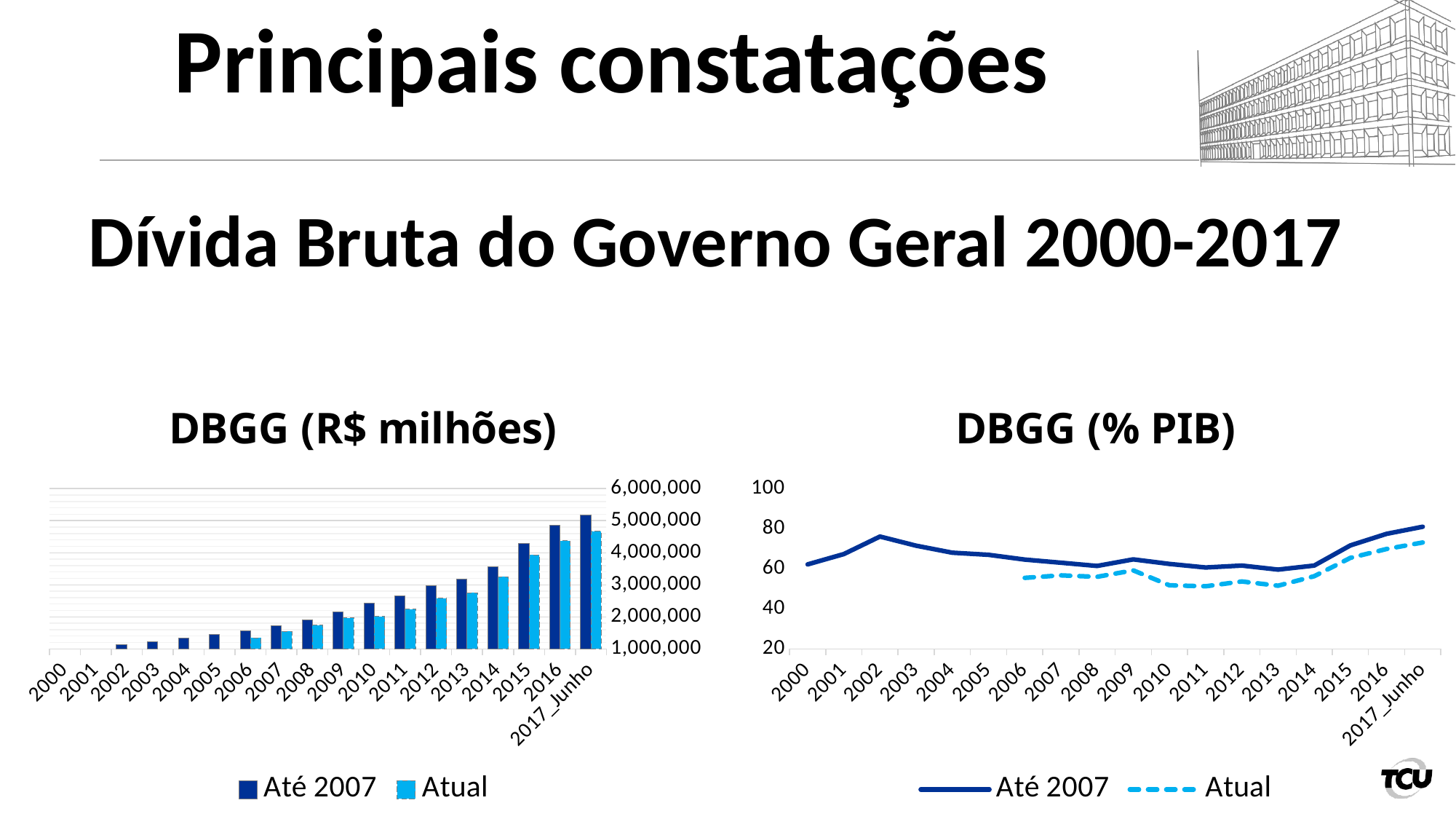
In the 'DBGG (% PIB)' chart, is the 'Atual' value for 2010 greater or less than 60? less In the 'DBGG (R$ milhões)' chart, is the 'Atual' value for 2017_Junho greater or less than 4,000,000? greater How many categories are shown on the x axis of the 'DBGG (R$ milhões)' chart? 18 What kind of chart is the 'DBGG (% PIB)' chart on the right? line chart What kind of chart is the 'DBGG (R$ milhões)' chart on the left? bar chart In the 'DBGG (R$ milhões)' chart, do the 'Até 2007' values generally rise or fall from 2002 to 2017_Junho? rise How many series does the legend of the 'DBGG (R$ milhões)' chart list? 2 In the 'DBGG (R$ milhões)' chart, which is larger for 2017_Junho: 'Até 2007' or 'Atual'? Até 2007 In the 'DBGG (R$ milhões)' chart, which category has the highest 'Até 2007' bar? 2017_Junho In the 'DBGG (% PIB)' chart, is the 'Até 2007' value for 2002 greater or less than 70? greater In the 'DBGG (% PIB)' chart, which series is drawn with a dashed line? Atual